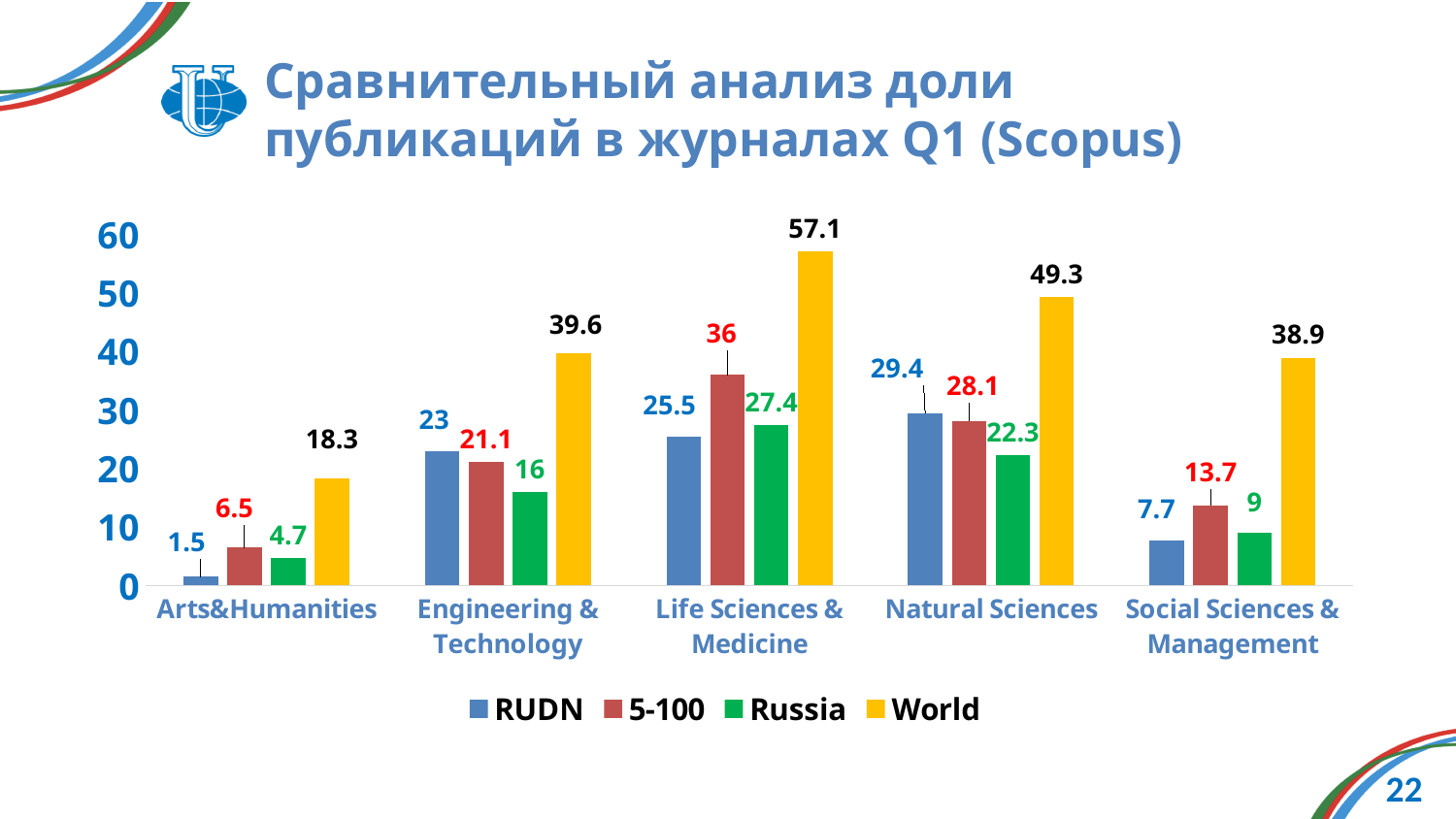
Which category has the lowest RUDN value? Arts&Humanities What is the World value for Life Sciences & Medicine? 57.1 What is the difference between the World and RUDN values for Natural Sciences? 19.9 What is the RUDN value for Engineering & Technology? 23 Which is larger for Life Sciences & Medicine: the 5-100 value or the Russia value? 5-100 How many categories are shown on the x axis? 5 What is the Russia value for Natural Sciences? 22.3 What kind of chart is shown on the slide? Bar chart How many series does the legend list? 4 Is the World value for Engineering & Technology greater or less than 30? greater What is the 5-100 value for Social Sciences & Management? 13.7 Which category has the highest World value? Life Sciences & Medicine